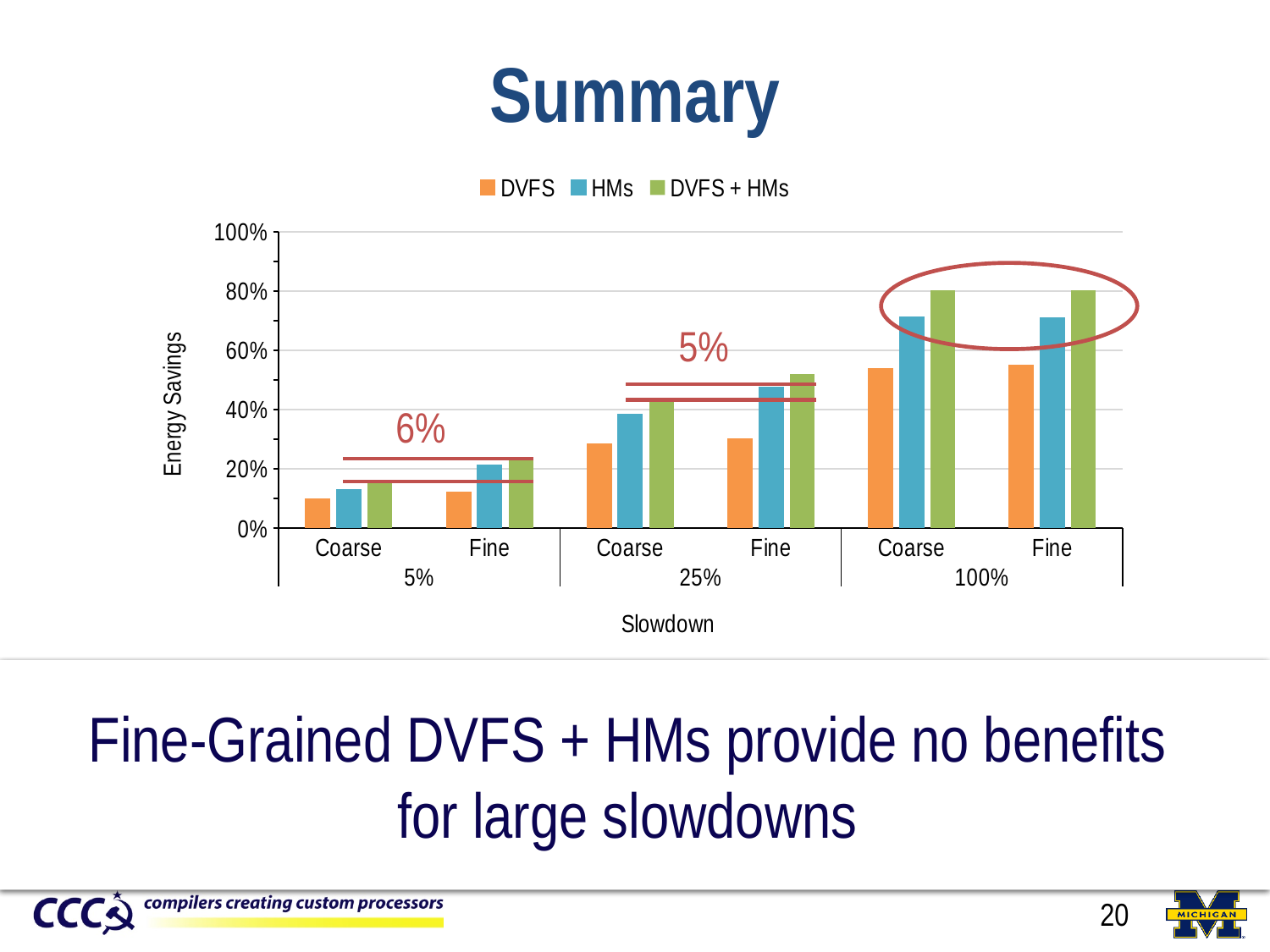
Which series has the highest energy savings for Coarse at 25% slowdown? DVFS + HMs Which series has the lowest energy savings for Fine at 100% slowdown? DVFS How many slowdown levels are shown along the x axis? 3 How many series does the legend list? 3 What is the label of the vertical axis? Energy Savings What are the three series named in the legend? DVFS, HMs, DVFS + HMs Do the DVFS + HMs energy savings rise or fall as slowdown increases from 5% to 100%? rise Is the DVFS value for Coarse at 5% slowdown greater or less than 20%? less Is the DVFS value for Fine at 100% slowdown greater or less than 40%? greater Is the DVFS + HMs value for Coarse at 100% slowdown greater or less than 60%? greater What kind of chart is shown on the slide? bar chart